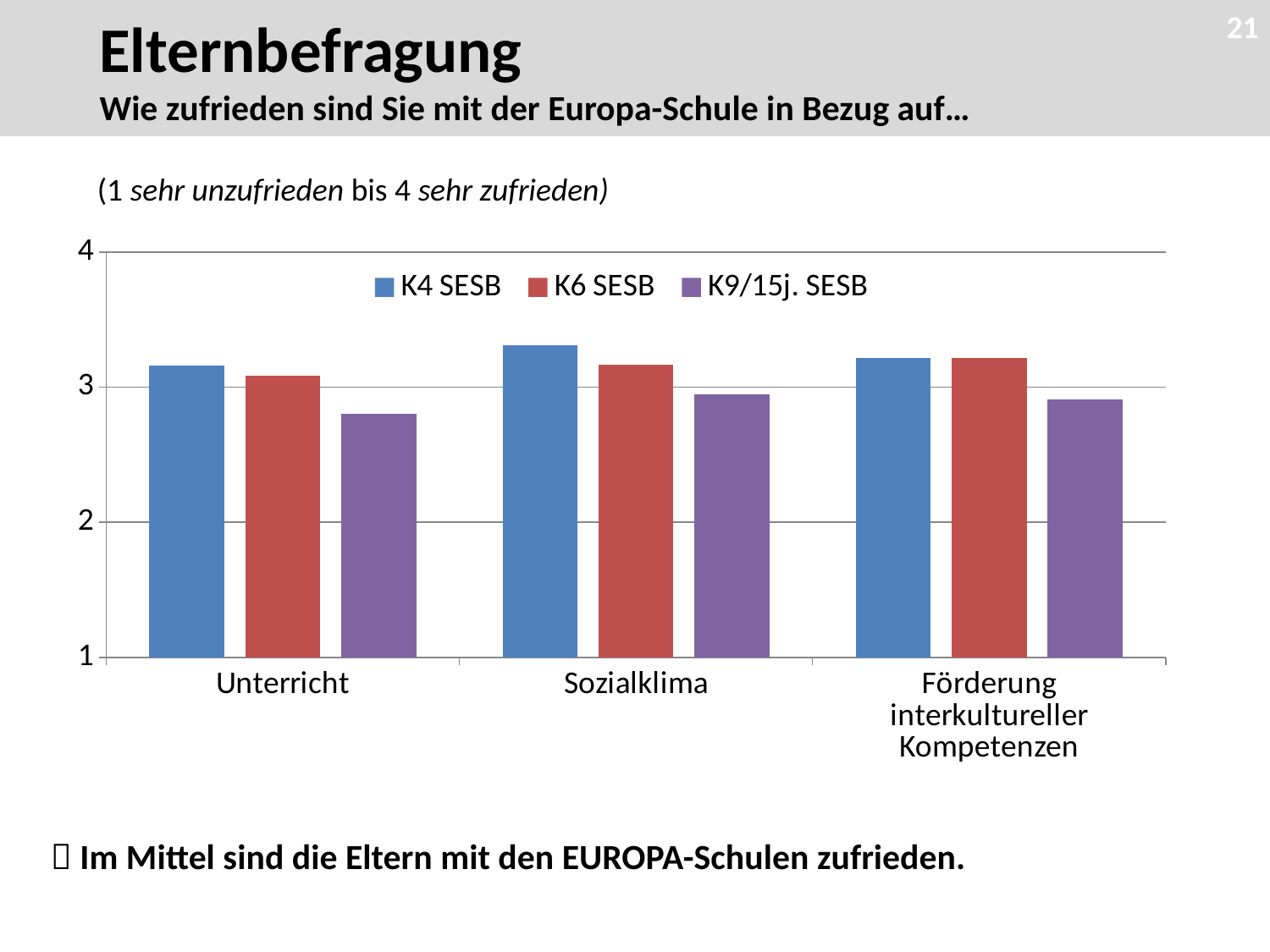
Is the value for K4 SESB in the Unterricht category greater or less than 3? greater How many series does the chart legend list? 3 For the K4 SESB series, which category has the highest value? Sozialklima For the K9/15j. SESB series, which category has the lowest value? Unterricht Is the value for K9/15j. SESB in the Unterricht category greater or less than 3? less Is the value for K9/15j. SESB in the Förderung interkultureller Kompetenzen category greater or less than 3? less How many categories are shown on the x axis of the chart? 3 What kind of chart is shown on the slide? bar chart In the Sozialklima category, which is larger: the value for K4 SESB or for K6 SESB? K4 SESB Which series are listed in the chart legend? K4 SESB, K6 SESB, K9/15j. SESB In the Unterricht category, which is larger: the value for K4 SESB or for K9/15j. SESB? K4 SESB